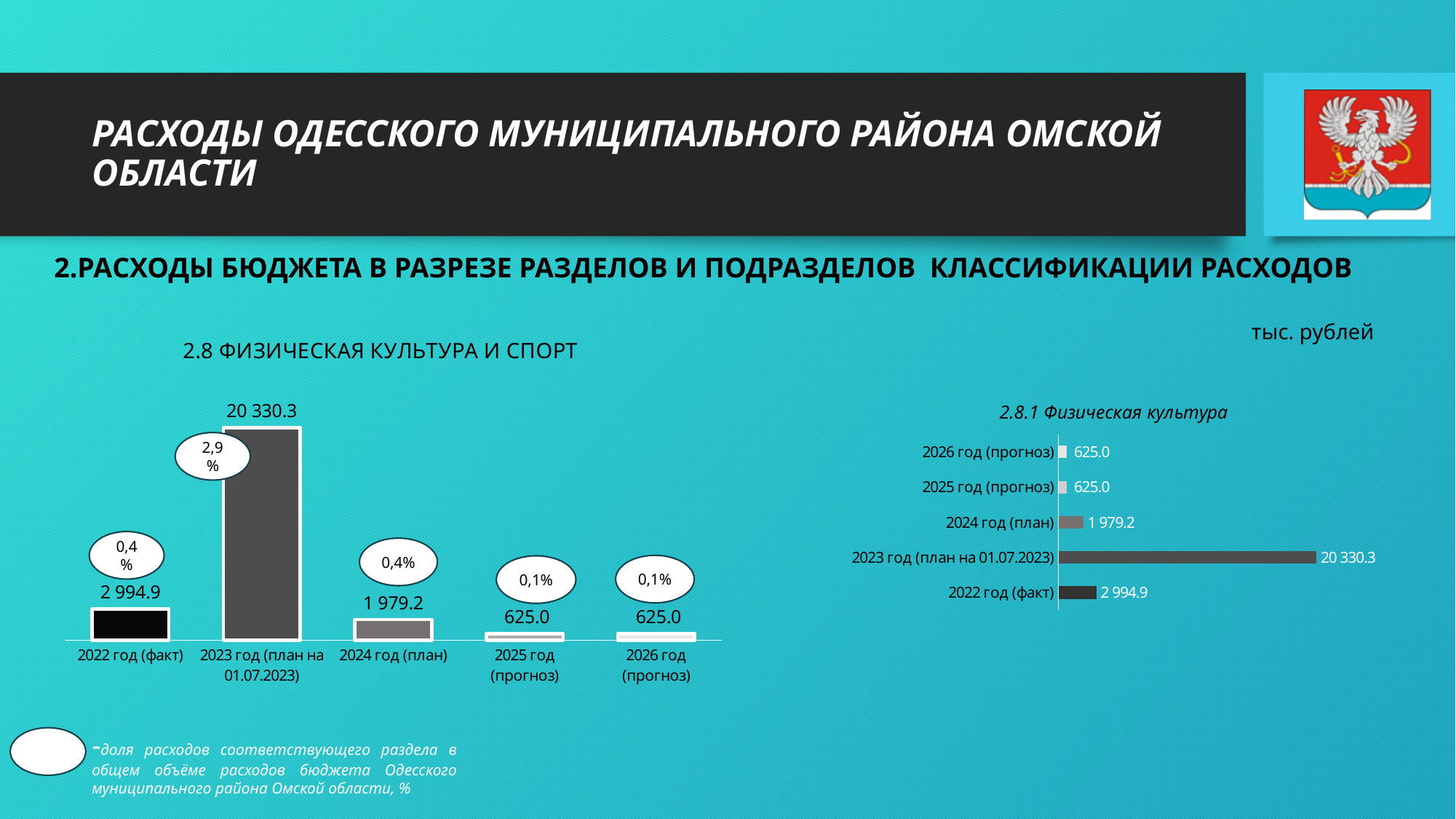
In the chart '2.8 ФИЗИЧЕСКАЯ КУЛЬТУРА И СПОРТ', what is the value for 2022 год (факт)? 2 994.9 In the chart '2.8.1 Физическая культура', which category has the lowest value? 2025 год (прогноз) and 2026 год (прогноз) (both 625.0) In the chart '2.8 ФИЗИЧЕСКАЯ КУЛЬТУРА И СПОРТ', what is the value for 2023 год (план на 01.07.2023)? 20 330.3 What kind of chart is '2.8.1 Физическая культура'? Bar chart In the chart '2.8 ФИЗИЧЕСКАЯ КУЛЬТУРА И СПОРТ', do the values rise or fall from 2023 год (план на 01.07.2023) to 2026 год (прогноз)? Fall In the chart '2.8.1 Физическая культура', what is the value for 2024 год (план)? 1 979.2 In the chart '2.8 ФИЗИЧЕСКАЯ КУЛЬТУРА И СПОРТ', which category has the highest value? 2023 год (план на 01.07.2023) In the chart '2.8.1 Физическая культура', which is larger: the value for 2022 год (факт) or the value for 2024 год (план)? 2022 год (факт) In the chart '2.8 ФИЗИЧЕСКАЯ КУЛЬТУРА И СПОРТ', how many categories are plotted? 5 In the chart '2.8 ФИЗИЧЕСКАЯ КУЛЬТУРА И СПОРТ', what is the difference between the values for 2022 год (факт) and 2024 год (план)? 1 015.7 In the chart '2.8 ФИЗИЧЕСКАЯ КУЛЬТУРА И СПОРТ', what share of total budget expenditure is shown in the oval above the 2023 год (план на 01.07.2023) bar? 2,9% In the chart '2.8.1 Физическая культура', what is the value for 2025 год (прогноз)? 625.0